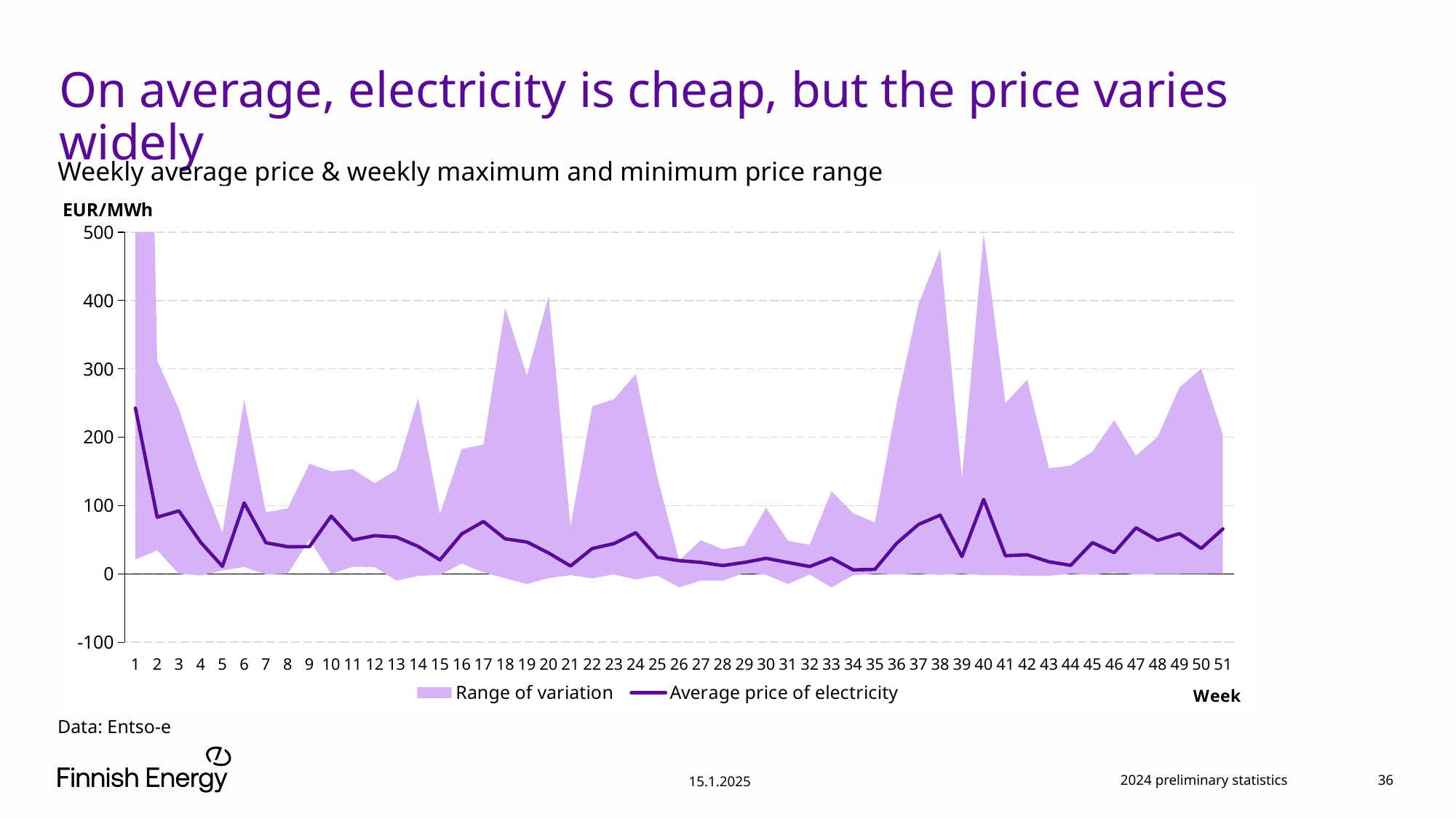
Is the upper end of the range of variation in week 38 greater or less than 400 EUR/MWh? greater Which is larger, the average price of electricity in week 1 or in week 40? Week 1 Does the average price of electricity rise or fall from week 1 to week 5? fall What kind of chart is shown on the slide? area and line chart How many series does the legend list? 2 Is the average price of electricity in week 5 greater or less than 100 EUR/MWh? less In which week is the average price of electricity highest? Week 1 How many weeks are shown on the x axis? 51 Which is larger, the average price of electricity in week 17 or in week 21? Week 17 Is the average price of electricity in week 21 greater or less than 100 EUR/MWh? less What unit is shown on the y axis of the chart? EUR/MWh